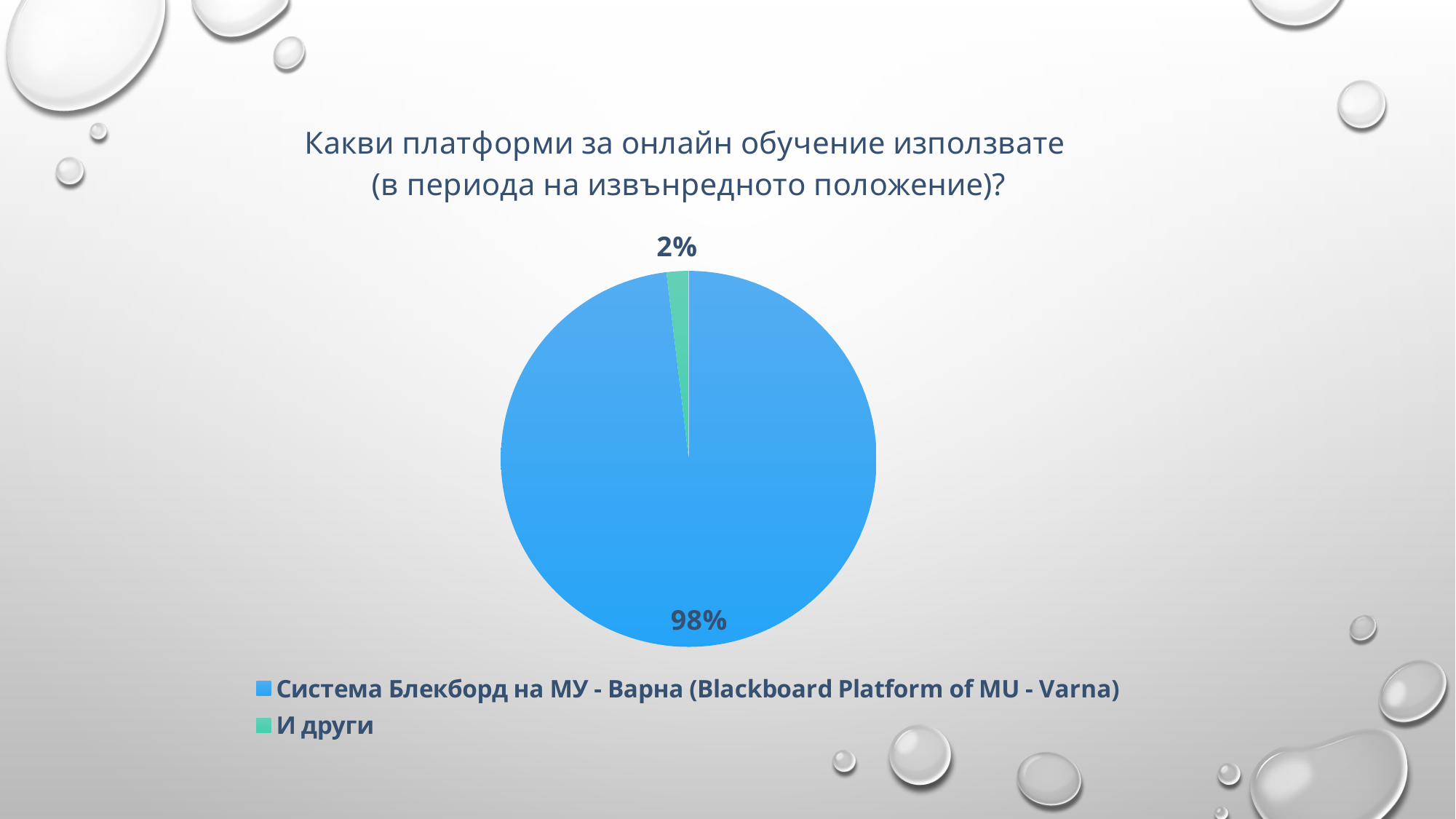
What colour is the slice for "И други"? green What is the difference in percentage points between the Blackboard Platform of MU - Varna slice and the "И други" slice? 96 What share of the pie does "И други" have? 2% How many categories does the pie chart have? 2 What share of the pie does "Система Блекборд на МУ - Варна (Blackboard Platform of MU - Varna)" have? 98% What is the title of the chart? Какви платформи за онлайн обучение използвате (в периода на извънредното положение)? Which is larger: the slice for Blackboard Platform of MU - Varna or the slice for "И други"? Blackboard Platform of MU - Varna How many entries does the legend list? 2 Which category has the largest slice of the pie? Система Блекборд на МУ - Варна (Blackboard Platform of MU - Varna) What kind of chart is shown on the slide? pie chart Which category has the smallest slice of the pie? И други